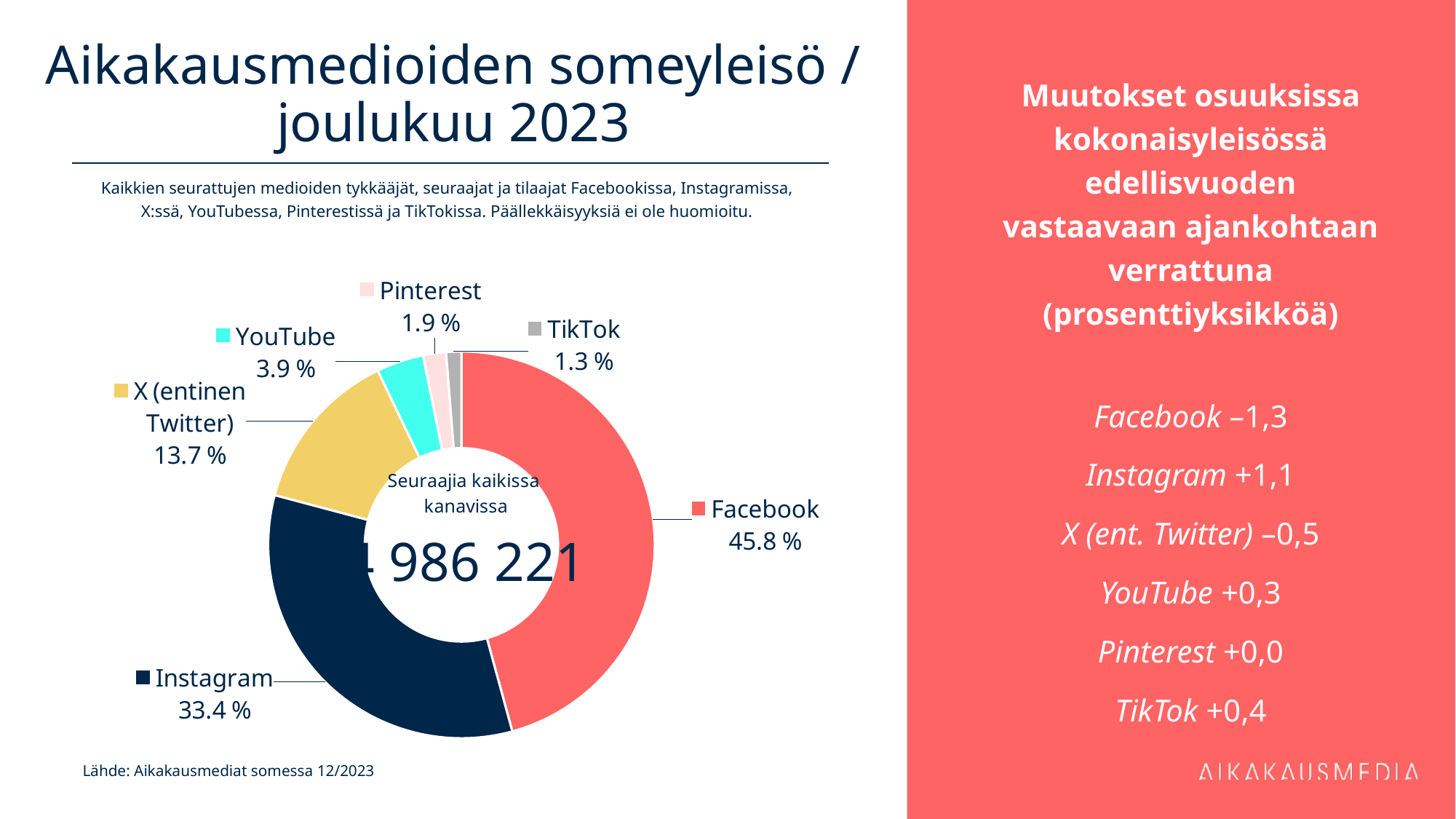
Which platform has the smallest share in the chart? TikTok What is the combined share of Pinterest and TikTok? 3.2 % What share does X (entinen Twitter) have in the chart? 13.7 % What share of the social media audience does Instagram have? 33.4 % What kind of chart is shown on the slide? Pie chart (donut) Which has a larger share, Pinterest or YouTube? YouTube What is the difference in percentage points between Facebook's and Instagram's shares? 12.4 % What share does TikTok have in the chart? 1.3 % What share of the social media audience does Facebook have? 45.8 % Which platform has the largest share in the chart? Facebook How many platforms (slices) are shown in the chart? 6 What share does YouTube have in the chart? 3.9 %